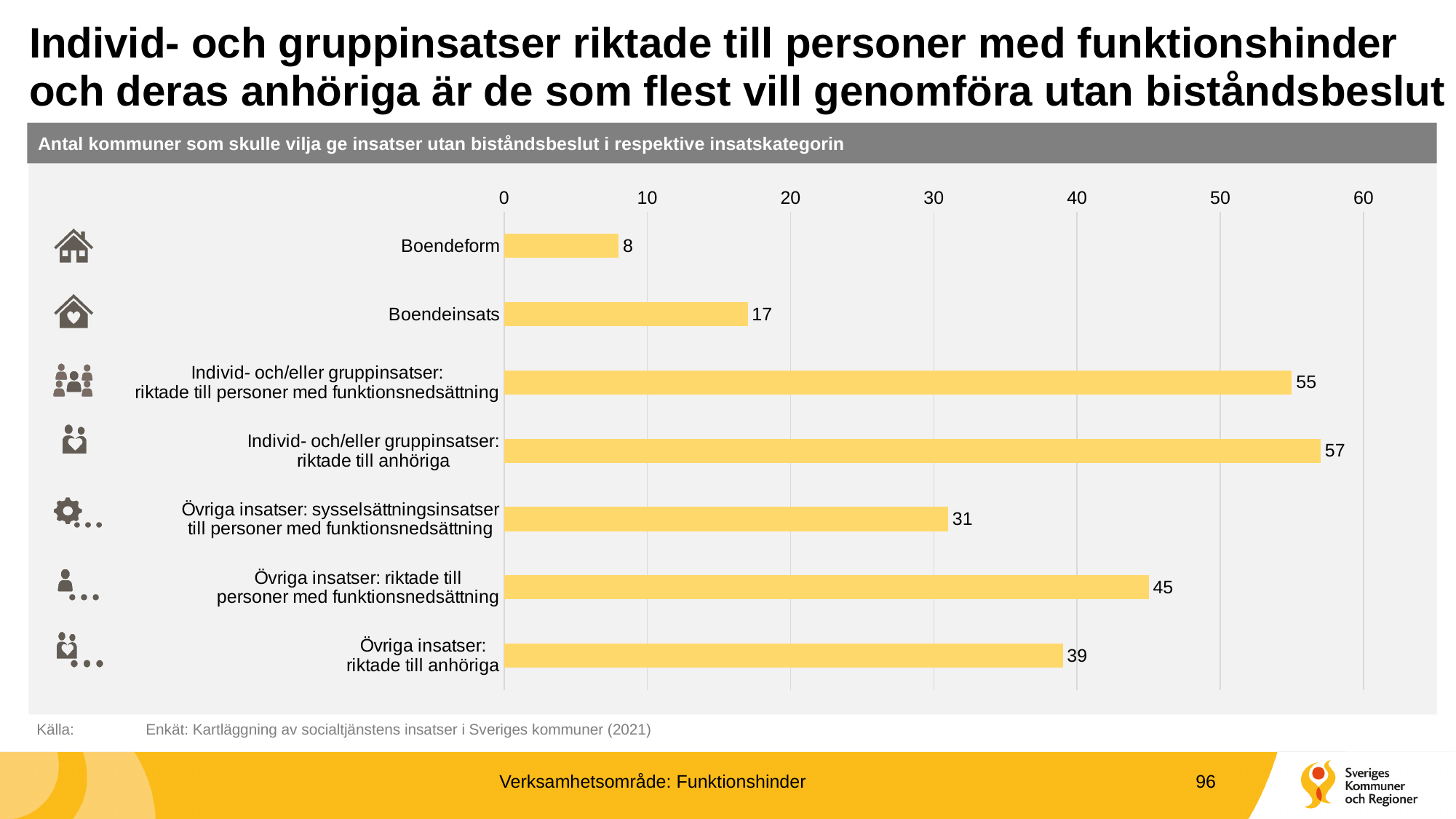
How many categories are shown in the chart? 7 What is the title of the chart? Antal kommuner som skulle vilja ge insatser utan biståndsbeslut i respektive insatskategorin Which category has the highest value? Individ- och/eller gruppinsatser: riktade till anhöriga What is the difference between Övriga insatser: riktade till personer med funktionsnedsättning and Övriga insatser: riktade till anhöriga? 6 Which is larger: Individ- och/eller gruppinsatser: riktade till personer med funktionsnedsättning or Övriga insatser: riktade till personer med funktionsnedsättning? Individ- och/eller gruppinsatser: riktade till personer med funktionsnedsättning What is the value for Övriga insatser: sysselsättningsinsatser till personer med funktionsnedsättning? 31 What kind of chart is shown on the slide? bar chart Is the value for Övriga insatser: riktade till anhöriga greater or less than 40? less Which category has the lowest value? Boendeform What is the value for Boendeinsats? 17 What is the value for Boendeform? 8 What is the value for Individ- och/eller gruppinsatser: riktade till anhöriga? 57